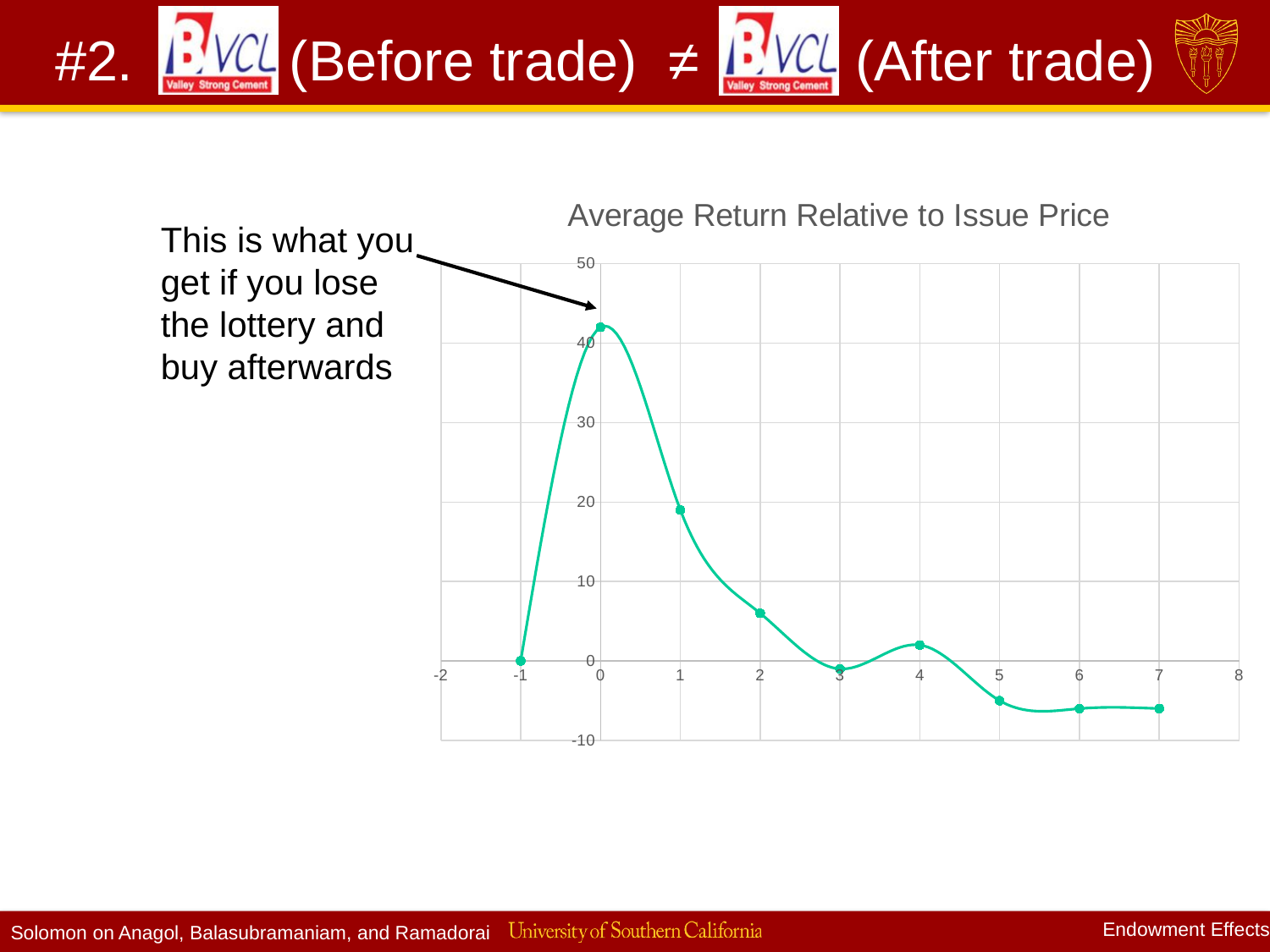
Is the value at x = 0 greater or less than 40? greater Is the value at x = 5 greater or less than 0? less Which has the larger value, x = 0 or x = 4? x = 0 Does the line rise or fall between x = 0 and x = 3? fall How many data points are plotted on the line? 9 At which x value does the line reach its highest point? 0 What is the title of the chart? Average Return Relative to Issue Price Which has the larger value, x = 1 or x = 2? x = 1 Is the value at x = 2 greater or less than 10? less What colour is the plotted line? green What kind of chart is shown on the slide? line chart